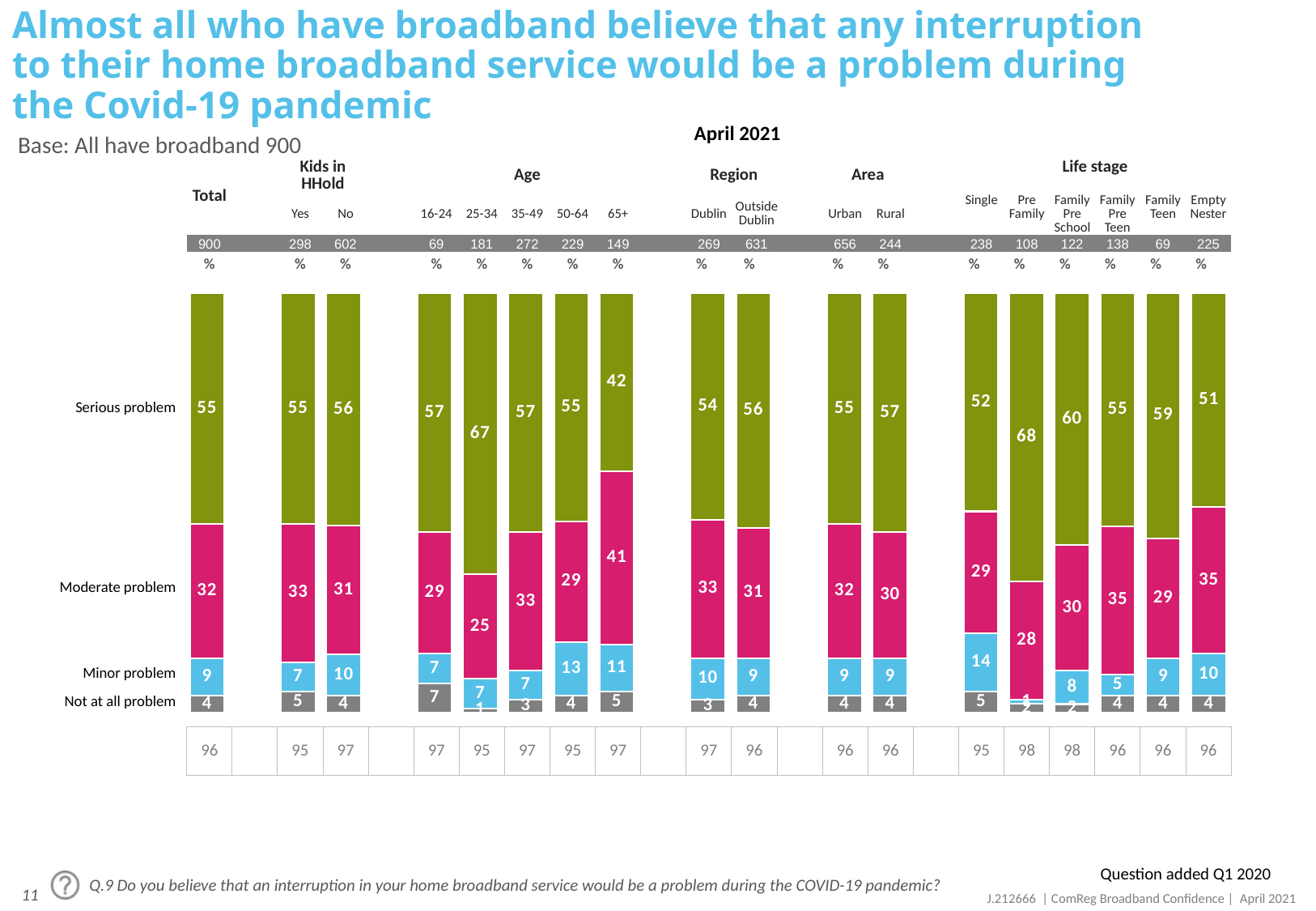
Which has a higher 'Serious problem' value, Urban or Rural? Rural What is the 'Moderate problem' value for the 65+ age group? 41 What is the base (sample size) shown for the Rural group? 244 What kind of chart is shown on the slide? Stacked bar chart What is the 'Minor problem' value for the Single life stage? 14 How many response categories (series) are stacked in each bar? 4 What percentage of the Total group say an interruption would be a serious problem? 55 Which category has the lowest 'Serious problem' value? 65+ How many bars are plotted in the chart? 18 Which category has the highest 'Serious problem' value? Pre Family What is the difference between the 'Serious problem' values for the 25-34 and 65+ age groups? 25 Which has a higher 'Moderate problem' value, Dublin or Outside Dublin? Dublin